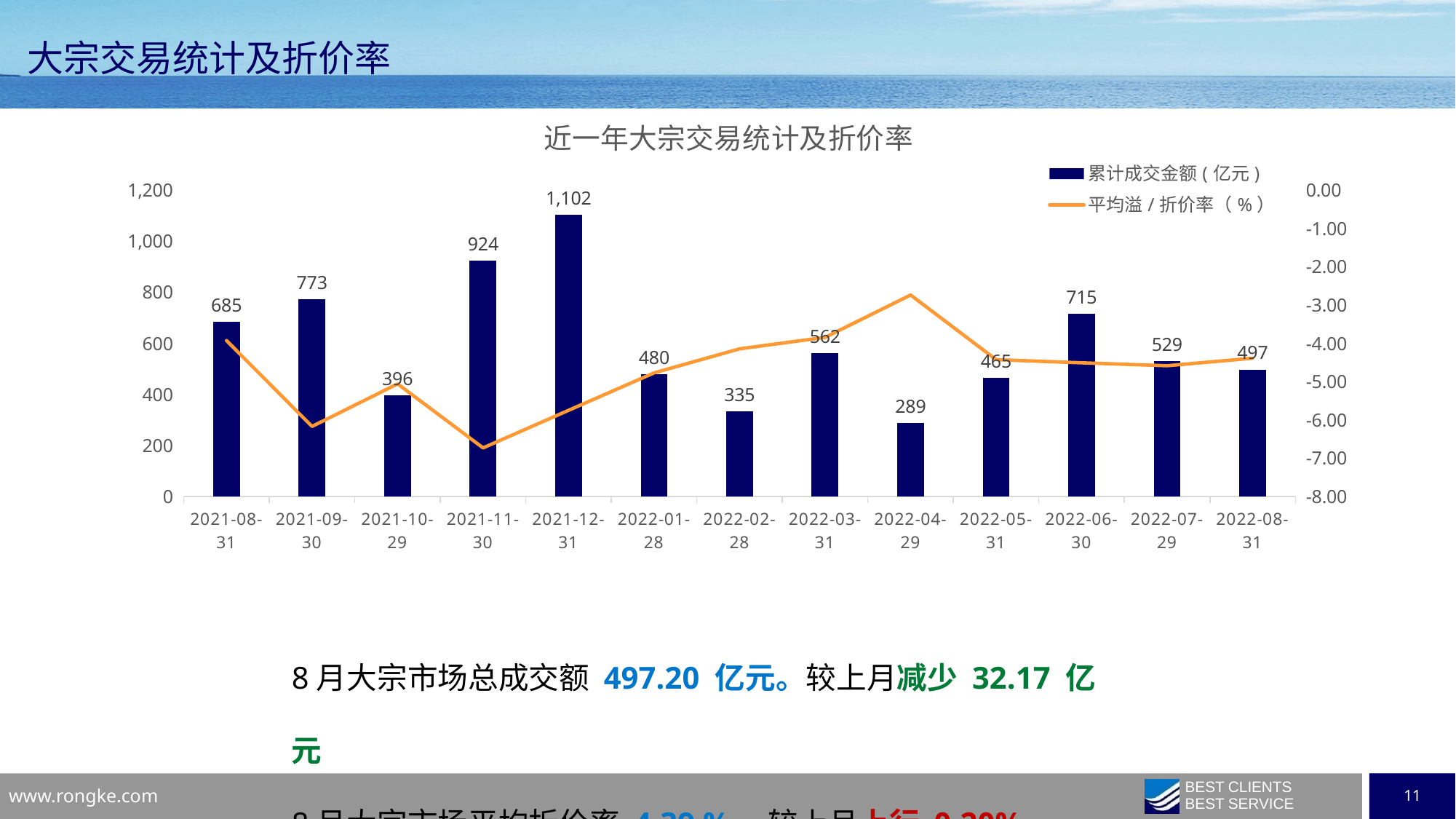
What is the 累计成交金额 value for 2022-08-31? 497 Is the 平均溢/折价率 value for 2022-04-29 greater or less than -4.00? greater What is the title of the chart? 近一年大宗交易统计及折价率 How many months are shown on the x axis? 13 Which month has the lowest 累计成交金额? 2022-04-29 How many series does the legend list? 2 Which is larger, the 累计成交金额 for 2021-09-30 or for 2022-06-30? 2021-09-30 What is the 累计成交金额 value for 2021-12-31? 1,102 Which month has the highest 累计成交金额? 2021-12-31 Is the 平均溢/折价率 value for 2021-11-30 greater or less than -6.00? less What is the difference in 累计成交金额 between 2022-07-29 and 2022-08-31? 32 What is the 累计成交金额 value for 2022-04-29? 289